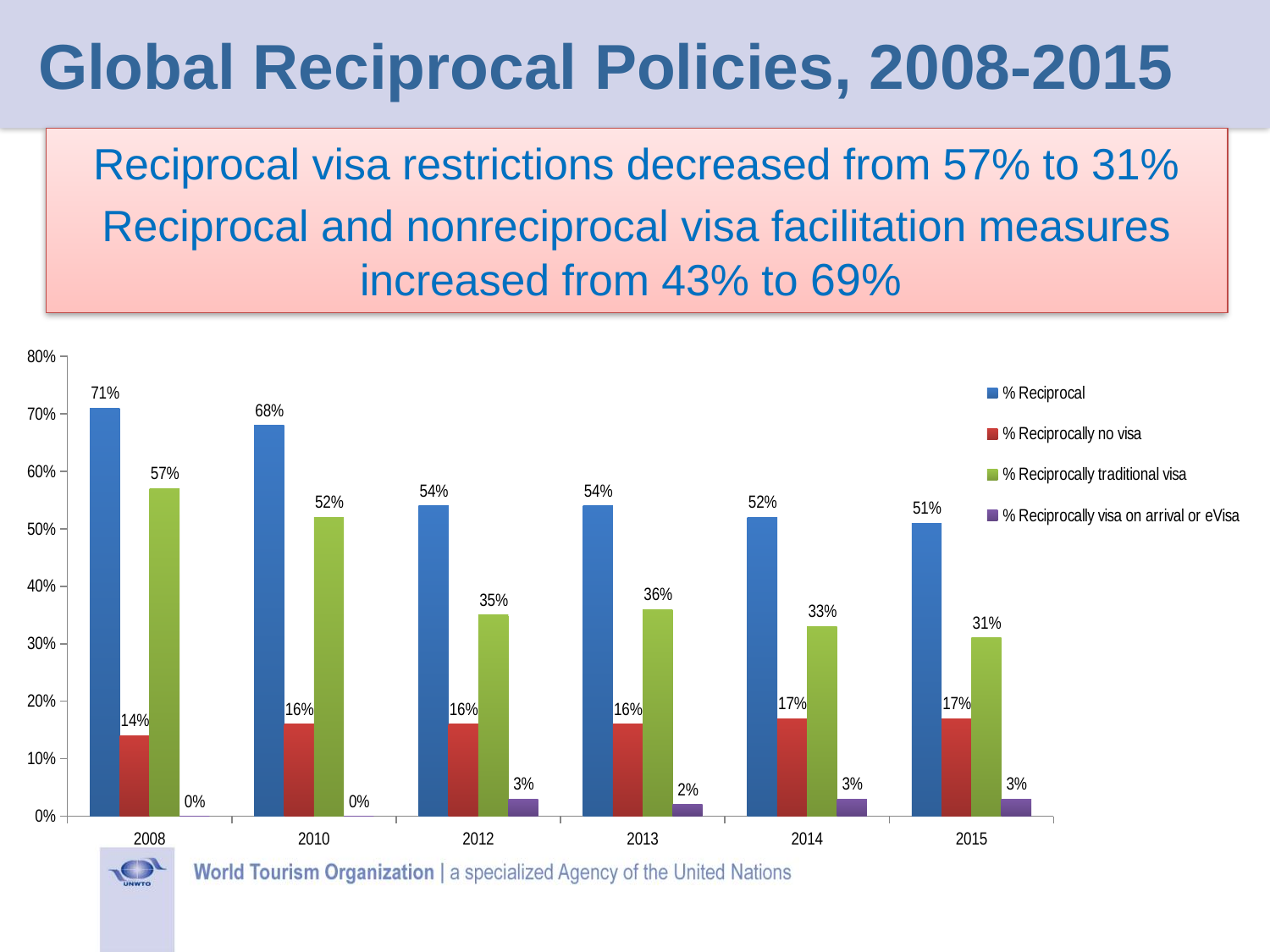
How many series does the legend list? 4 What is the value for % Reciprocal in 2008? 71% Which year has the lowest value for % Reciprocally traditional visa? 2015 Does the % Reciprocal series rise or fall from 2008 to 2015? Fall What is the value for % Reciprocally visa on arrival or eVisa in 2013? 2% What is the difference between the % Reciprocally traditional visa values in 2008 and 2015? 26% Which is larger in 2012: % Reciprocal or % Reciprocally traditional visa? % Reciprocal What is the value for % Reciprocally no visa in 2014? 17% How many years are shown on the x axis? 6 Which year has the highest value for % Reciprocal? 2008 What kind of chart is shown on the slide? Bar chart What is the value for % Reciprocally traditional visa in 2015? 31%